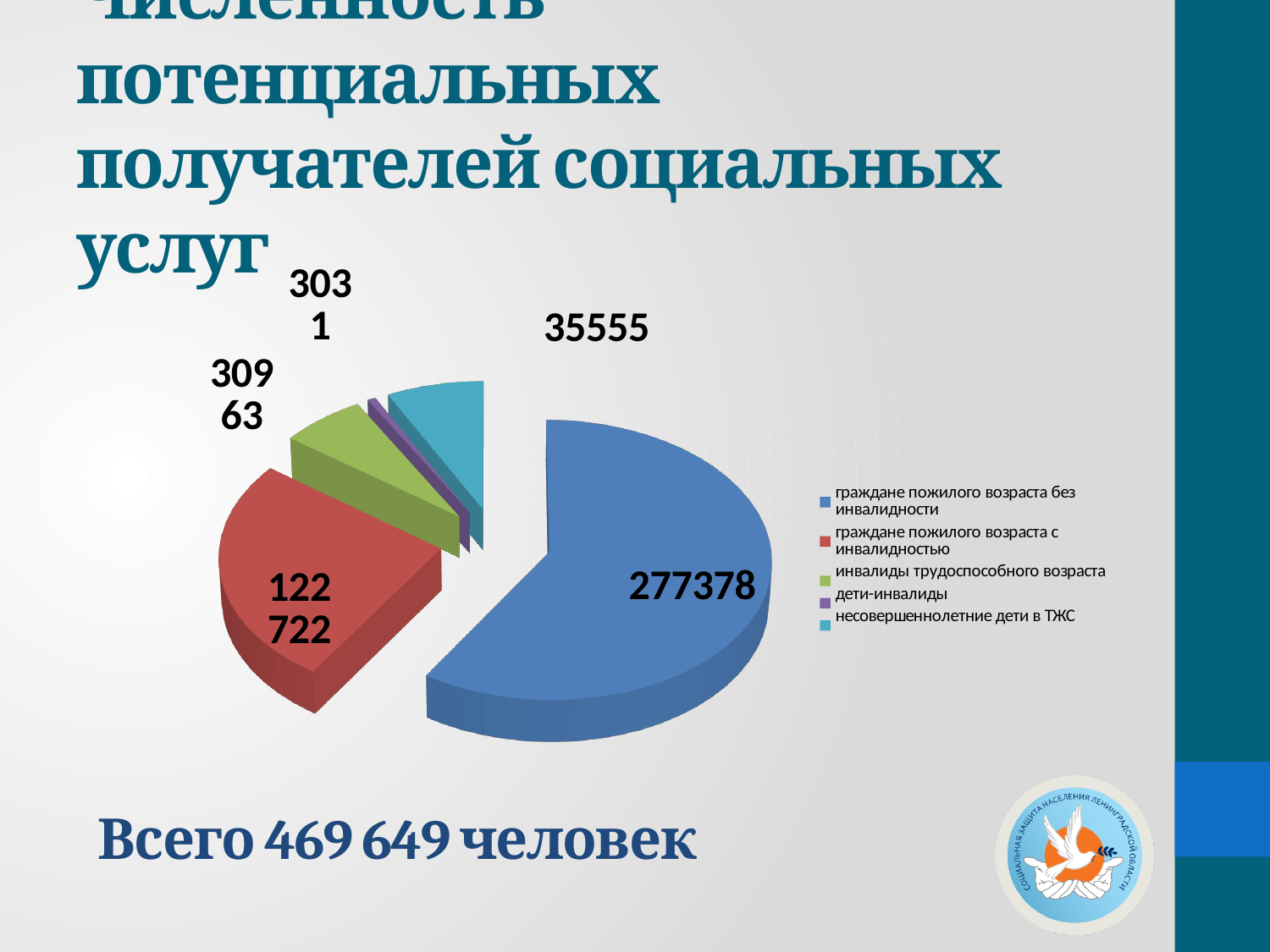
What total number of people is stated below the chart? 469 649 человек Which category has the largest slice of the pie? граждане пожилого возраста без инвалидности How many entries does the legend list? 5 What is the difference between the values for граждане пожилого возраста без инвалидности and граждане пожилого возраста с инвалидностью? 154656 What kind of chart is shown on the slide? pie chart Which is larger: the value for несовершеннолетние дети в ТЖС or the value for инвалиды трудоспособного возраста? несовершеннолетние дети в ТЖС What is the value for граждане пожилого возраста с инвалидностью? 122722 What is the value for дети-инвалиды? 3031 What is the value for граждане пожилого возраста без инвалидности? 277378 How many slices does the pie chart have? 5 Which category has the smallest slice of the pie? дети-инвалиды What is the value for несовершеннолетние дети в ТЖС? 35555